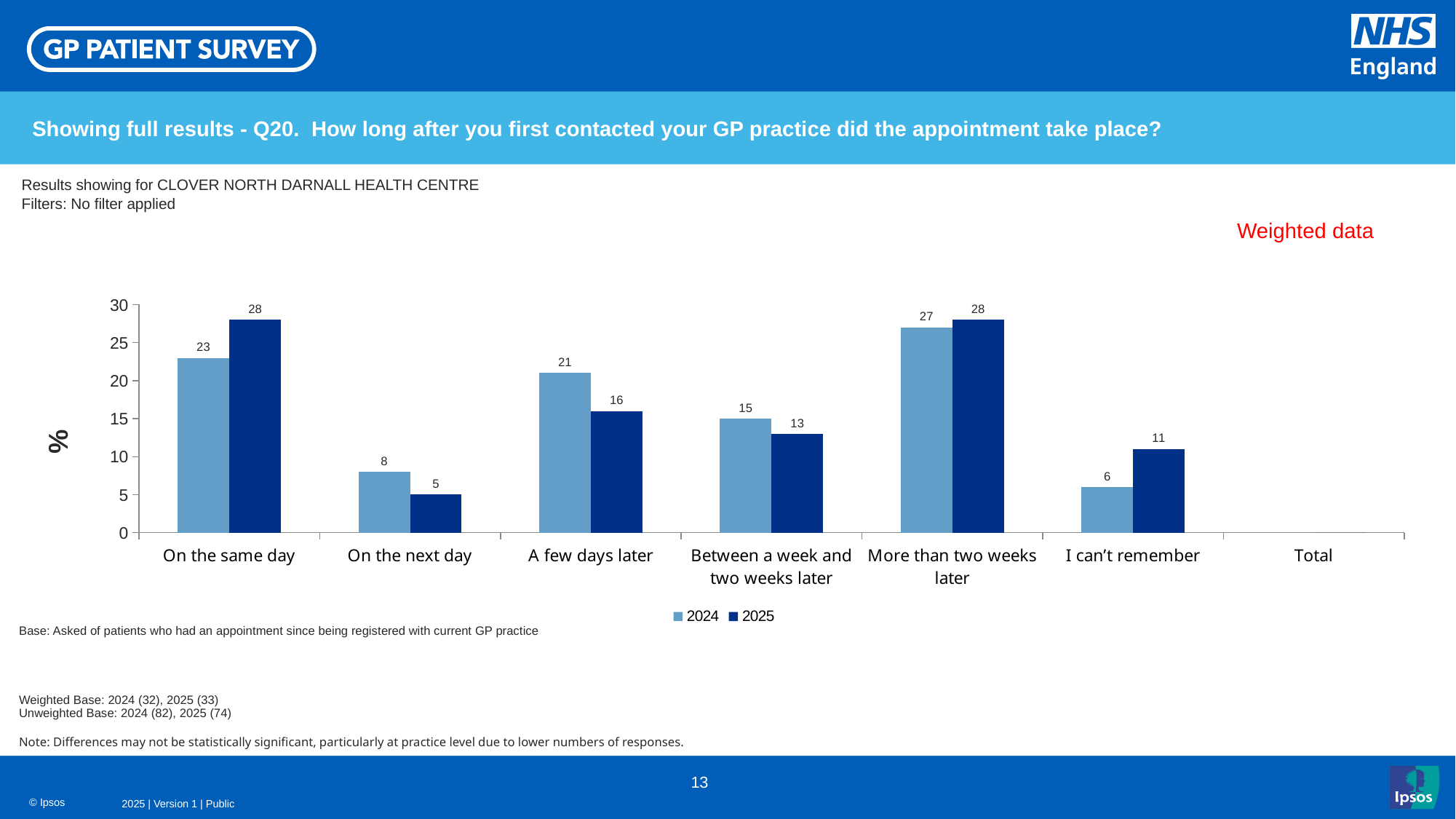
What is the 2024 value for 'Between a week and two weeks later'? 15 What are the two series named in the legend? 2024 and 2025 Which category has the highest 2024 value? More than two weeks later What is the 2025 value for 'I can't remember'? 11 What is the difference between the 2024 and 2025 values for 'A few days later'? 5 What kind of chart is shown on the slide? Bar chart How many series does the legend list? 2 Which is larger for 'I can't remember': the 2024 value or the 2025 value? 2025 Which category has the lowest 2025 value? On the next day What is the 2024 value for 'A few days later'? 21 What is the 2025 value for 'On the same day'? 28 What is the label on the vertical axis? %